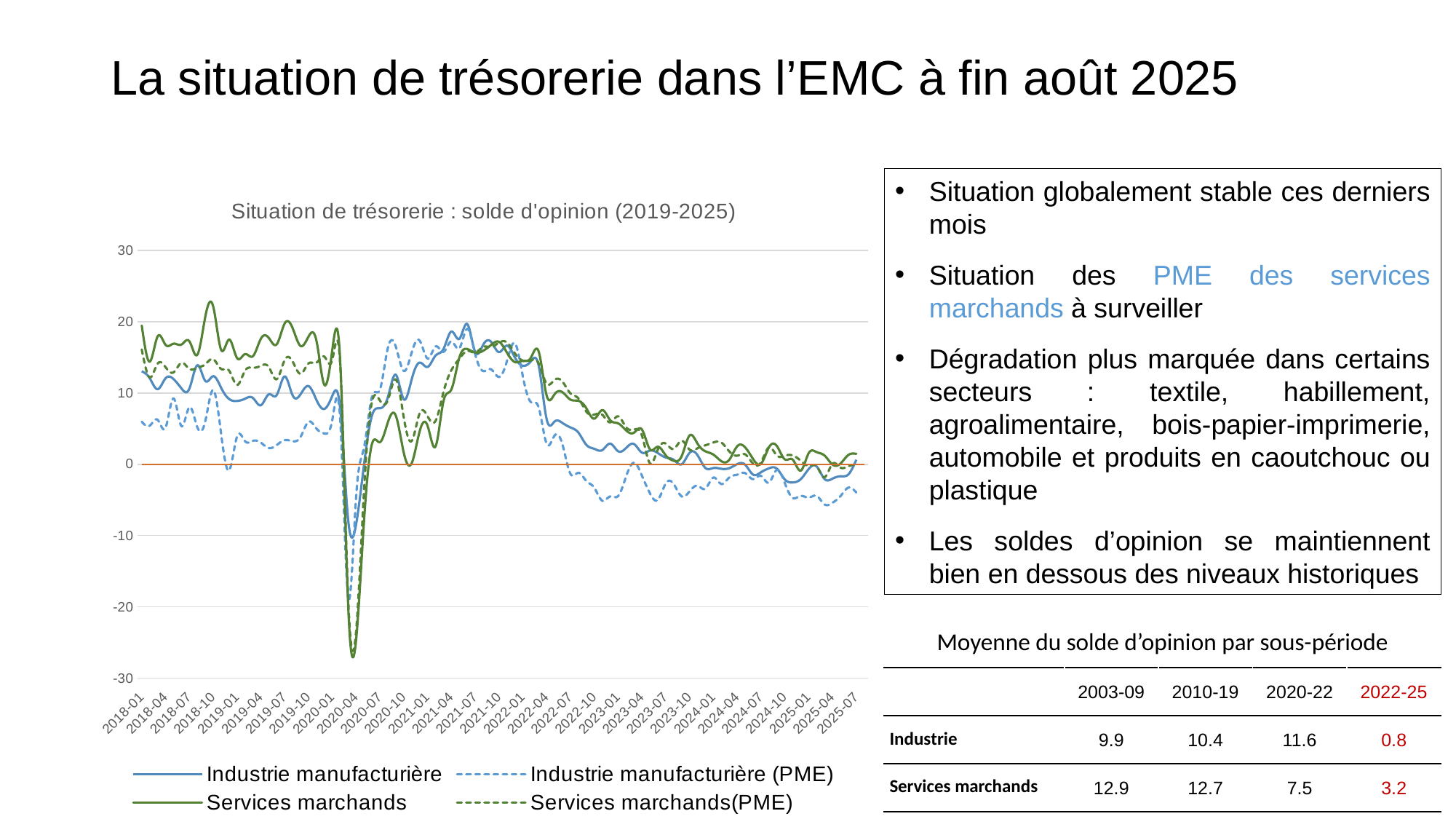
Does the Services marchands series rise or fall between 2022-01 and 2023-07? fall Is the value for Industrie manufacturière (PME) at 2018-01 greater or less than 10? less Is the value for Services marchands at 2020-04 greater or less than -20? less Is the value for Industrie manufacturière (PME) at 2023-01 greater or less than 0? less How many series does the chart legend list? 4 What kind of chart is shown on the slide? line chart What is the title of the chart? Situation de trésorerie : solde d'opinion (2019-2025) Which two series are drawn with dashed lines in the chart? Industrie manufacturière (PME) and Services marchands(PME) What is the highest value shown on the vertical axis of the chart? 30 At 2018-01, which is larger: Services marchands or Industrie manufacturière (PME)? Services marchands